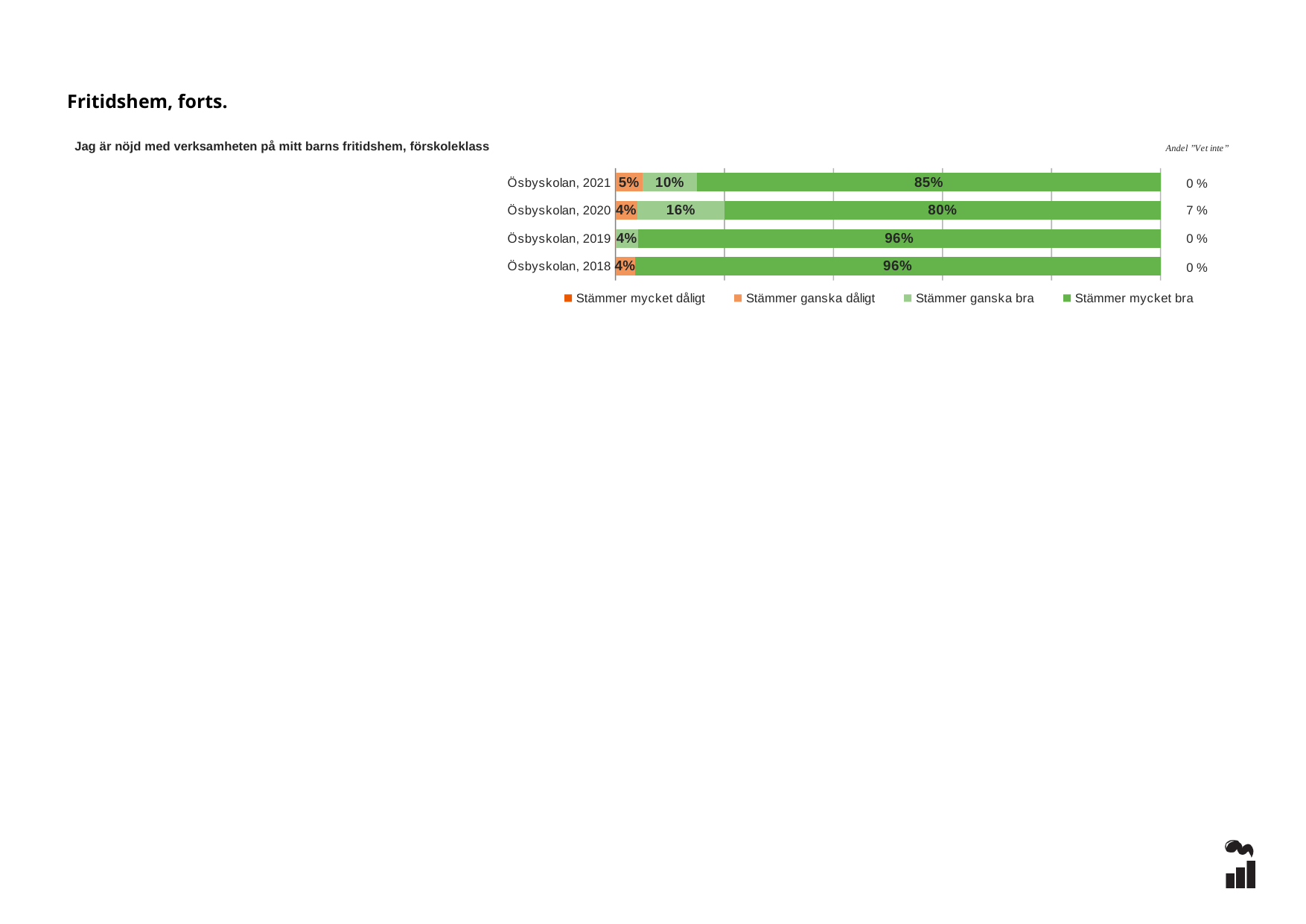
How many categories are shown on the chart? 4 How many series does the legend list? 4 What is the title of the chart? Jag är nöjd med verksamheten på mitt barns fritidshem, förskoleklass What is the difference between the "Stämmer mycket bra" values for Ösbyskolan, 2021 and Ösbyskolan, 2020? 5% What is the value for "Stämmer ganska dåligt" for Ösbyskolan, 2021? 5% Which is larger: the "Stämmer ganska bra" value for Ösbyskolan, 2020 or for Ösbyskolan, 2021? Ösbyskolan, 2020 What is the "Andel Vet inte" value shown for Ösbyskolan, 2020? 7 % What is the value for "Stämmer mycket bra" for Ösbyskolan, 2019? 96% What is the value for "Stämmer ganska bra" for Ösbyskolan, 2020? 16% What kind of chart is shown on the slide? Stacked bar chart What is the value for "Stämmer mycket bra" for Ösbyskolan, 2021? 85% Which category has the lowest value for "Stämmer mycket bra"? Ösbyskolan, 2020